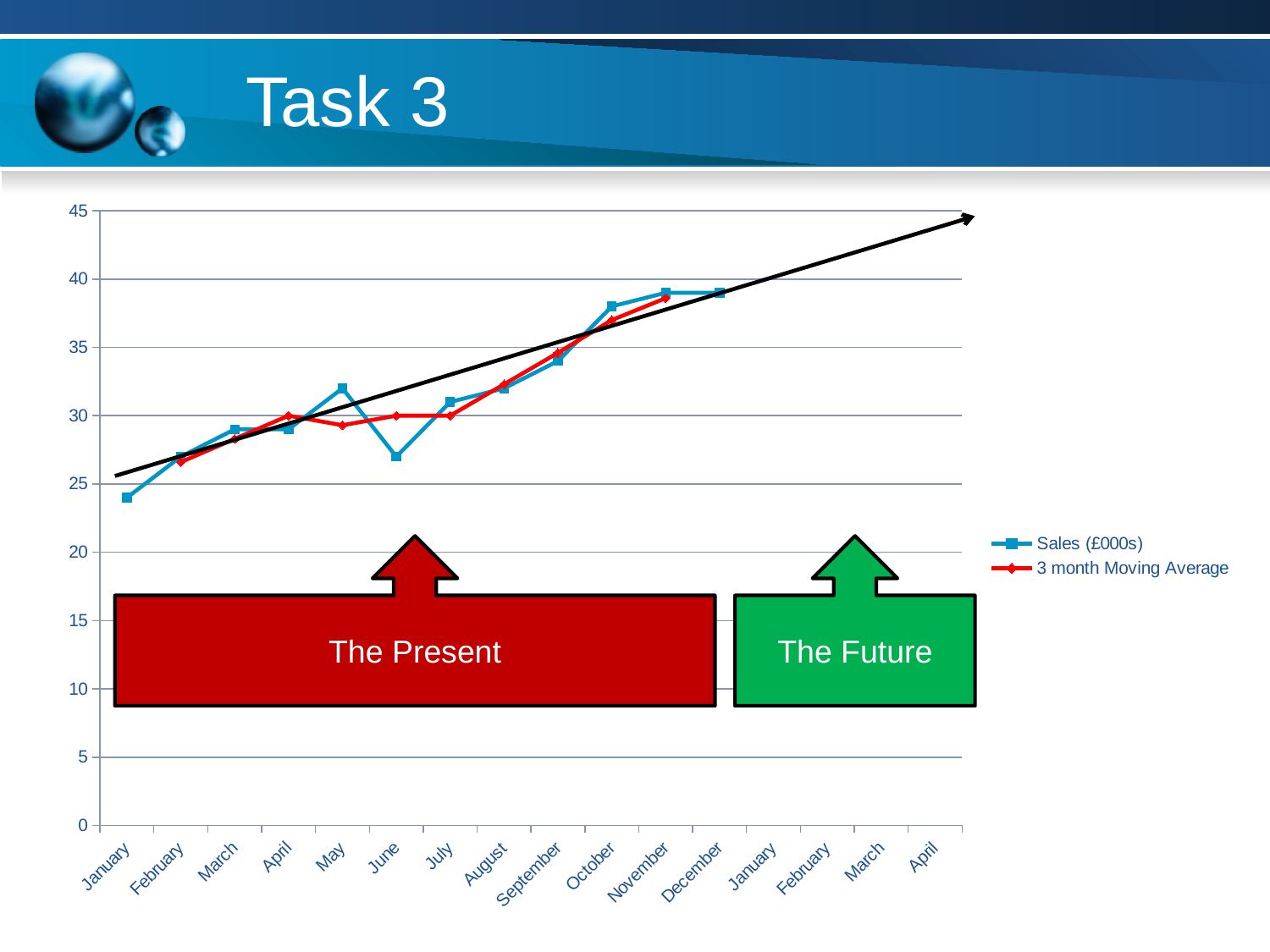
Which is larger, the Sales (£000s) value for May or for June? May Is the Sales (£000s) value for December greater or less than 40? less Is the Sales (£000s) value for January greater or less than 25? less How many series does the legend list? 2 In which month is the Sales (£000s) value lowest? January Is the Sales (£000s) value for October greater or less than 35? greater What are the two series named in the legend? Sales (£000s) and 3 month Moving Average How many month labels are shown along the x axis? 16 What kind of chart is shown on the slide? line chart Do the Sales (£000s) values generally rise or fall from January to December? rise